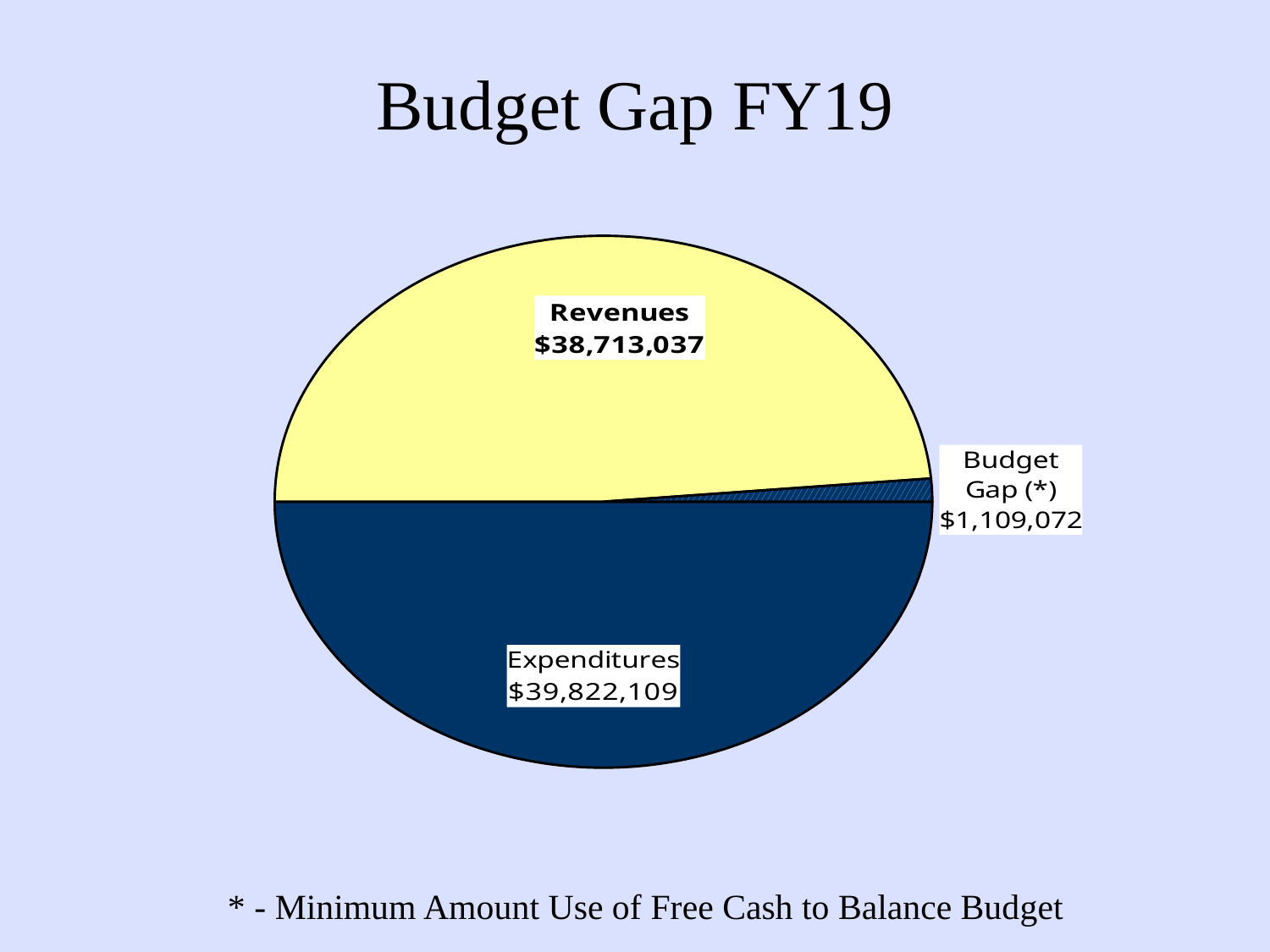
Which slice of the pie has the largest value? Expenditures What is the title of the slide? Budget Gap FY19 Which is larger, Expenditures or Revenues? Expenditures Which slice of the pie has the smallest value? Budget Gap (*) How many slices does the pie chart have? 3 What is the value shown for Revenues? $38,713,037 What is the difference between Expenditures and Revenues? $1,109,072 What is the value shown for Expenditures? $39,822,109 What type of chart is shown on the slide? Pie chart What is the value shown for Budget Gap (*)? $1,109,072 What colour is the Revenues slice? Yellow